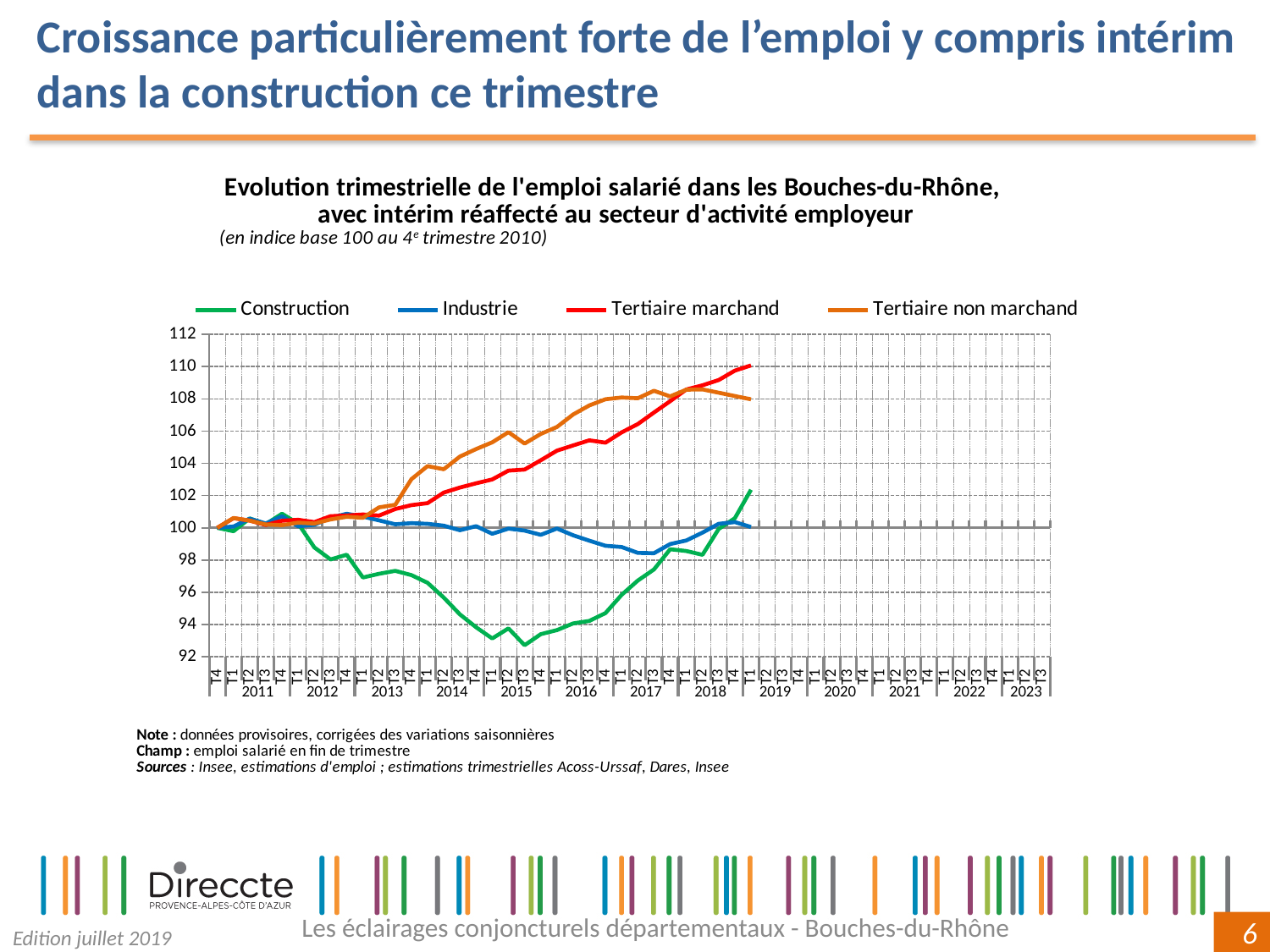
What is the index value of the series at the base quarter, T4 2010? 100 Which series has the highest value at T1 2019? Tertiaire marchand Is the value for Tertiaire marchand at T1 2019 greater or less than 108? greater At T1 2019, which is larger: Construction or Industrie? Construction Which series are listed in the legend? Construction, Industrie, Tertiaire marchand, Tertiaire non marchand Does the Tertiaire marchand series rise or fall from 2011 to 2019? rise Is the value for Industrie at T3 2017 greater or less than 100? less Which series has the lowest value at T3 2015? Construction How many series does the legend list? 4 What kind of chart is shown on the slide? line chart Is the value for Construction at T3 2015 greater or less than 94? less Which colour is used for the Tertiaire non marchand series? orange